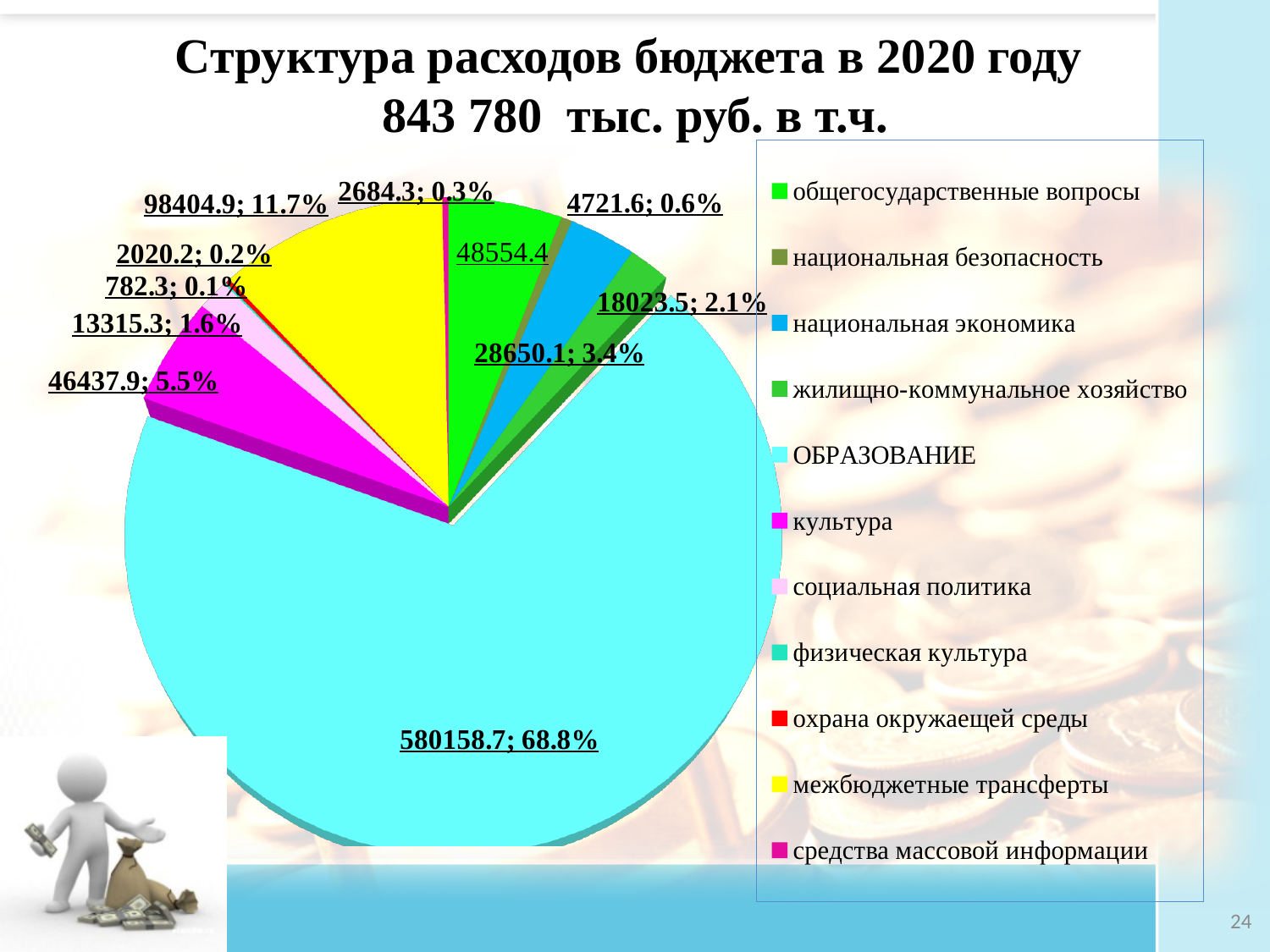
What share of the pie does национальная экономика account for? 3.4% What total amount in thousand rubles is stated in the chart title? 843 780 What value is labelled on the ОБРАЗОВАНИЕ slice? 580158.7 Which is larger, the slice for культура or the slice for жилищно-коммунальное хозяйство? культура What is the difference in percentage points between the ОБРАЗОВАНИЕ share (68.8%) and the межбюджетные трансферты share (11.7%)? 57.1 What share of the pie does ОБРАЗОВАНИЕ account for? 68.8% What value is labelled on the культура (magenta) slice? 46437.9 What share of the pie does межбюджетные трансферты account for? 11.7% Which category has the largest slice of the pie chart? ОБРАЗОВАНИЕ How many categories does the legend of the pie chart list? 11 What value is labelled on the межбюджетные трансферты (yellow) slice? 98404.9 What kind of chart is shown on the slide? pie chart